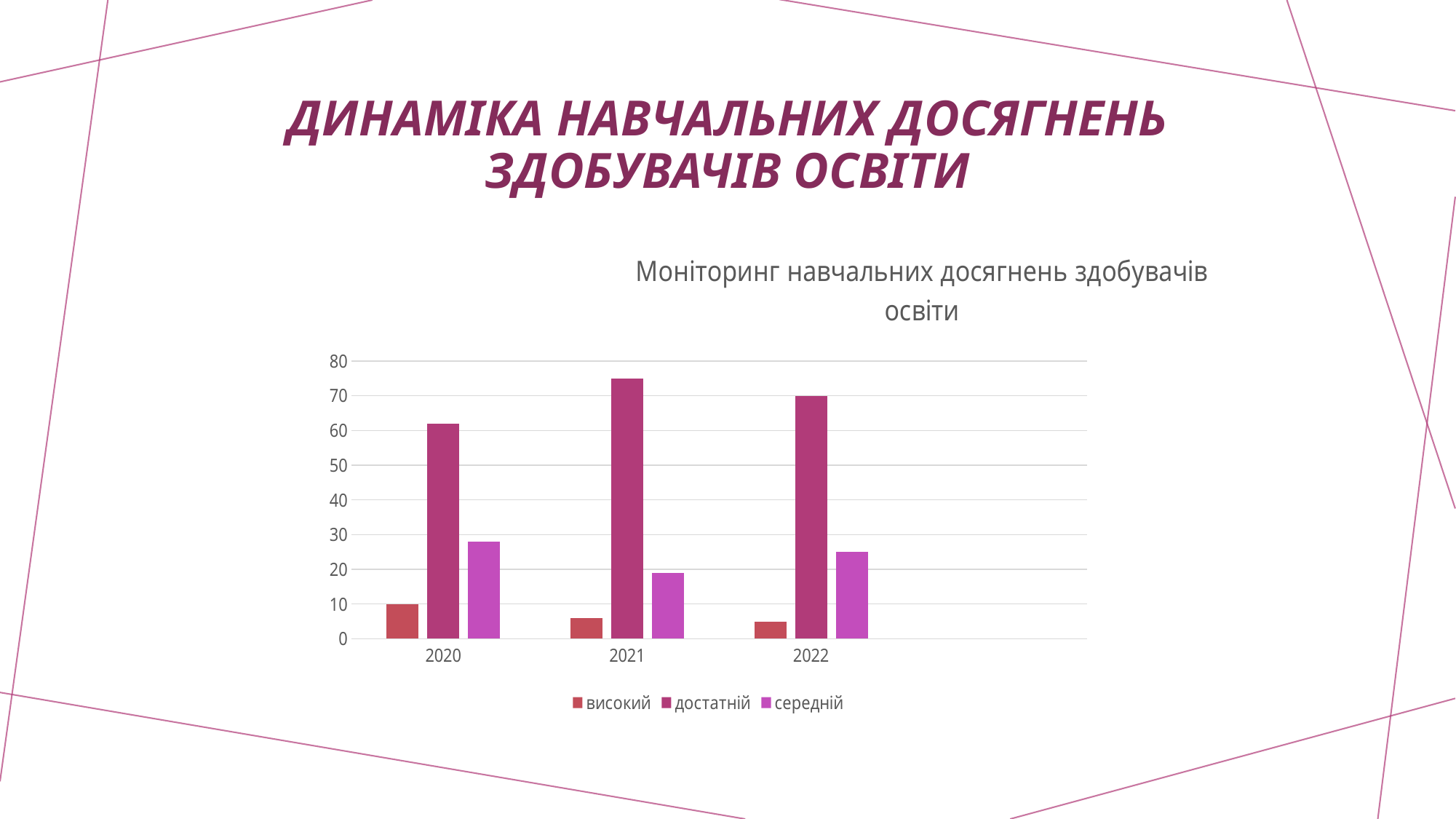
Is the value for достатній in 2021 greater or less than 70? greater Which is larger, середній in 2020 or середній in 2021? середній in 2020 In which year is the value for високий the highest? 2020 How many years are shown on the x axis? 3 Which series is lowest in every year? високий How many series does the legend list? 3 What kind of chart is shown on the slide? bar chart Which series is highest in every year? достатній Is the value for достатній in 2020 greater or less than 60? greater What is the title of the chart? Моніторинг навчальних досягнень здобувачів освіти In which year is the value for достатній the highest? 2021